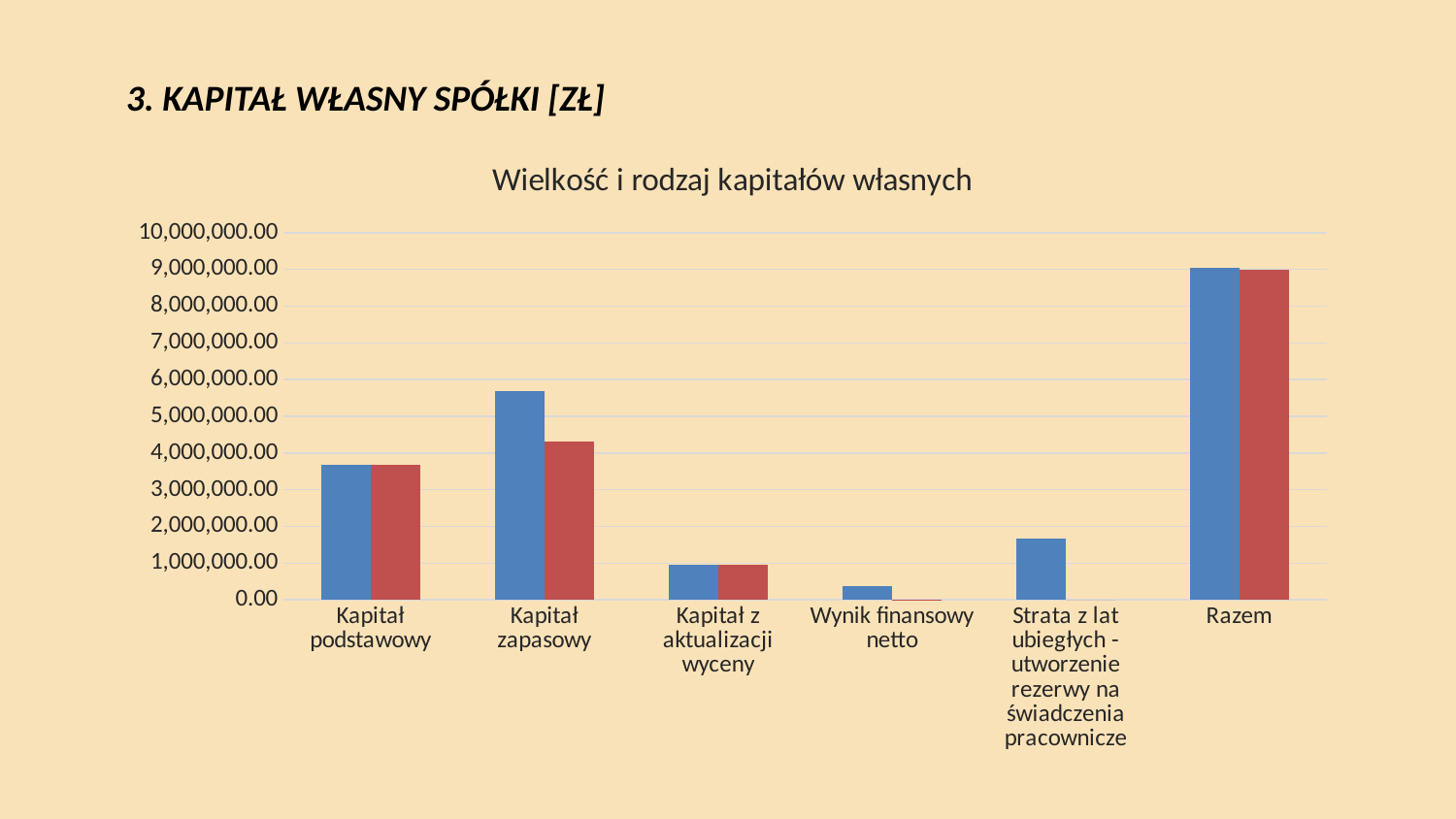
How many categories are shown on the x axis of the chart? 6 Is the blue bar for Razem greater or less than 8,000,000.00? greater Is the blue bar for Kapitał podstawowy greater or less than 4,000,000.00? less Is the blue bar for Strata z lat ubiegłych - utworzenie rezerwy na świadczenia pracownicze greater or less than 1,000,000.00? greater Which category has the tallest blue bar? Razem What type of chart is shown on the slide? bar chart What is the title of the chart? Wielkość i rodzaj kapitałów własnych For Kapitał zapasowy, is the blue bar or the red bar taller? blue Which category has the shortest blue bar? Wynik finansowy netto